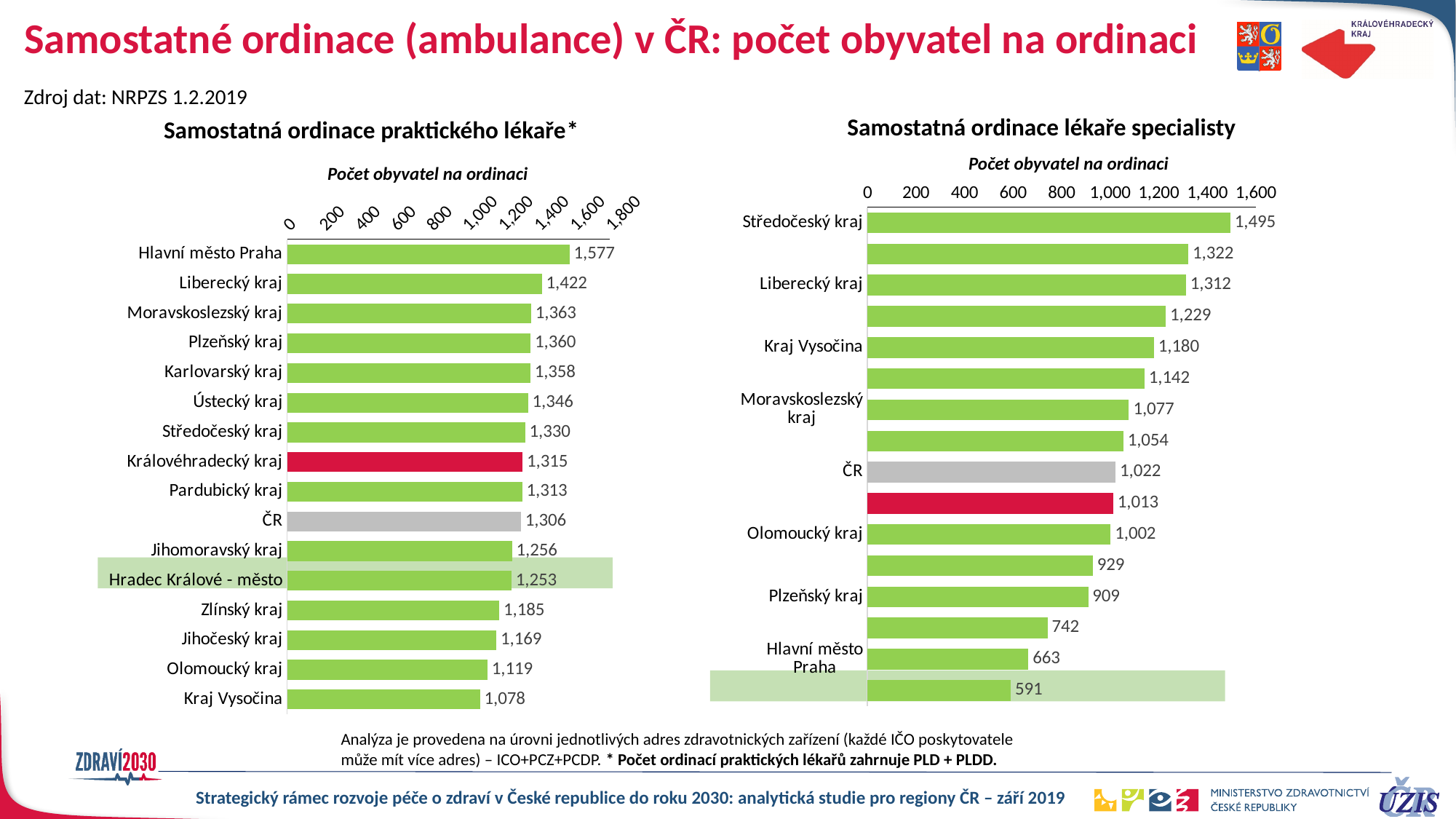
In the chart 'Samostatná ordinace praktického lékaře*', which category has the highest value? Hlavní město Praha In the chart 'Samostatná ordinace lékaře specialisty', what is the value for ČR? 1,022 In the chart 'Samostatná ordinace praktického lékaře*', how many bars are plotted? 16 In the chart 'Samostatná ordinace lékaře specialisty', what is the value for Středočeský kraj? 1,495 In the chart 'Samostatná ordinace lékaře specialisty', is the value for Hlavní město Praha greater or less than 800? less In the chart 'Samostatná ordinace lékaře specialisty', what is the difference between Liberecký kraj and Plzeňský kraj? 403 In the chart 'Samostatná ordinace praktického lékaře*', which is larger: Liberecký kraj or Moravskoslezský kraj? Liberecký kraj In the chart 'Samostatná ordinace praktického lékaře*', what is the value for Královéhradecký kraj? 1,315 In the chart 'Samostatná ordinace praktického lékaře*', which category has the lowest value? Kraj Vysočina What type of chart is 'Samostatná ordinace lékaře specialisty'? bar chart In the chart 'Samostatná ordinace praktického lékaře*', what is the difference between Hlavní město Praha and Kraj Vysočina? 499 In the chart 'Samostatná ordinace praktického lékaře*', what is the value for Hlavní město Praha? 1,577